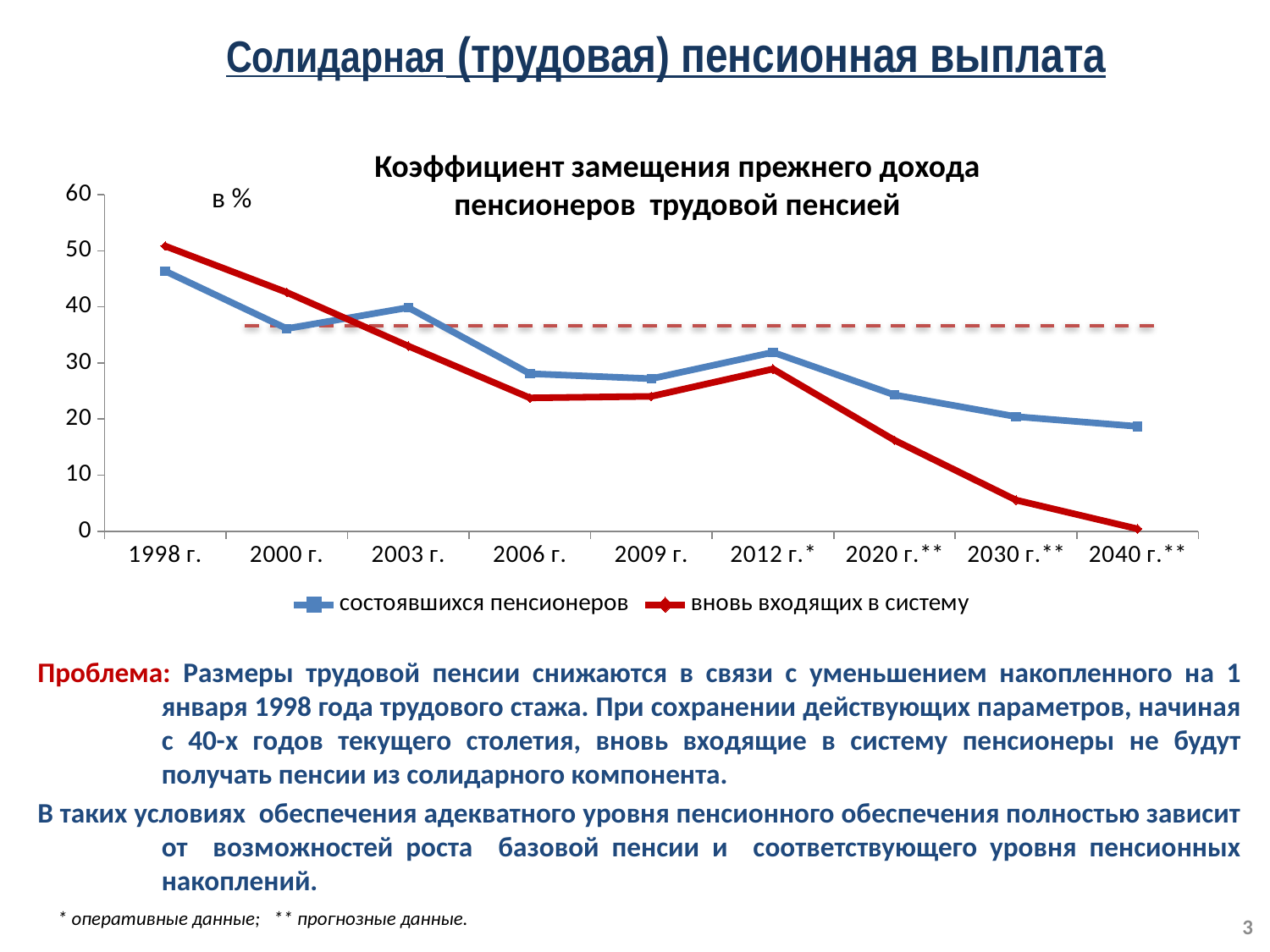
In 1998 г., which series has the higher value: "состоявшихся пенсионеров" or "вновь входящих в систему"? вновь входящих в систему How many years are shown on the x axis? 9 In which year is the value for "состоявшихся пенсионеров" lowest? 2040 г.** Is the value for "вновь входящих в систему" in 2020 г.** greater or less than 20? less Overall, do the values for "вновь входящих в систему" rise or fall from 1998 г. to 2040 г.**? fall Is the value for "состоявшихся пенсионеров" in 1998 г. greater or less than 40? greater Is the value for "вновь входящих в систему" in 2040 г.** greater or less than 10? less In which year is the value for "вновь входящих в систему" highest? 1998 г. In 2040 г.**, which series has the higher value: "состоявшихся пенсионеров" or "вновь входящих в систему"? состоявшихся пенсионеров How many series does the legend list? 2 What kind of chart is shown on the slide? line chart In which year is the value for "вновь входящих в систему" lowest? 2040 г.**